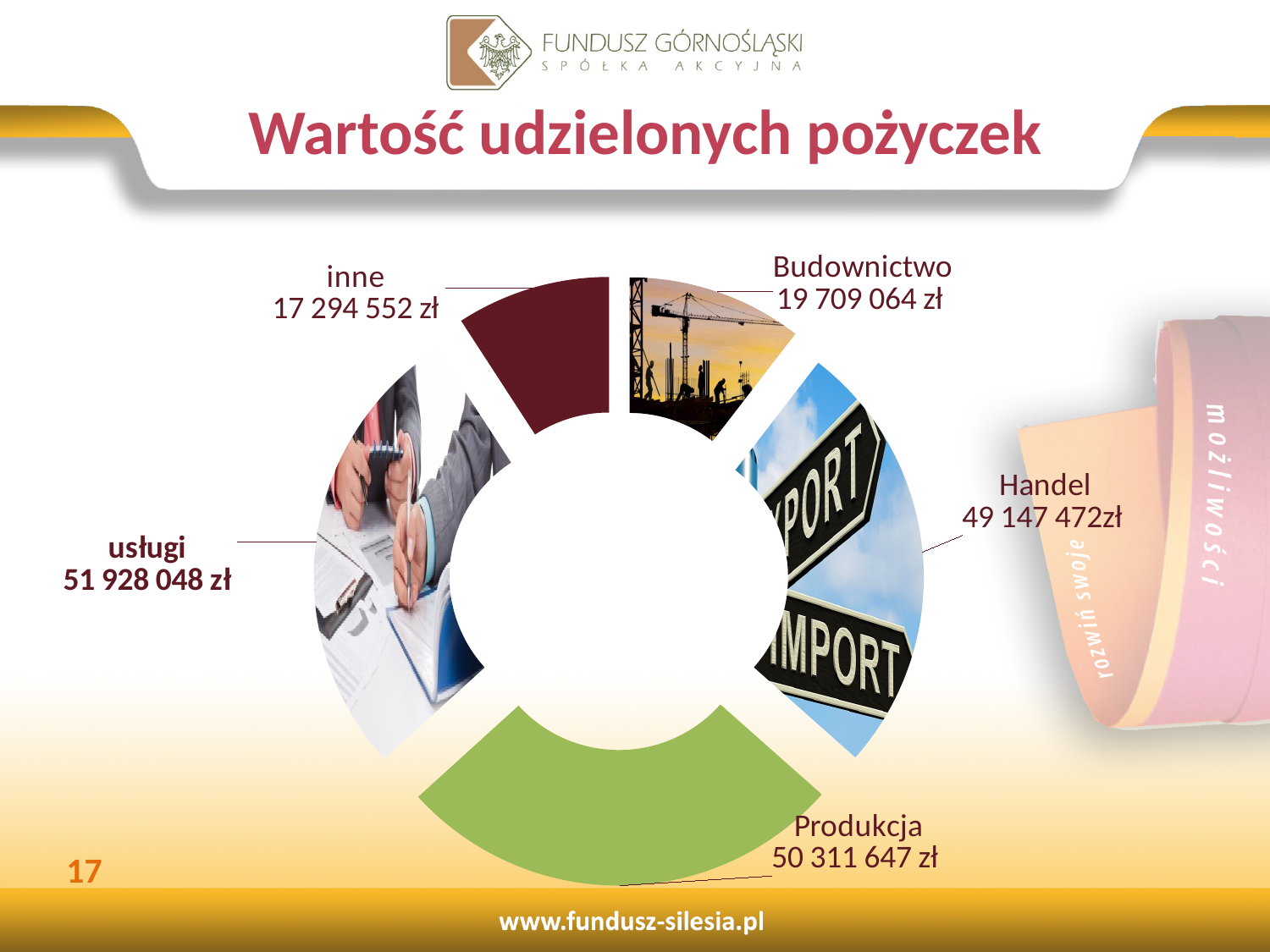
What is the value shown for inne? 17 294 552 zł What is the value of loans granted for Handel? 49 147 472zł What is the title of the slide containing the chart? Wartość udzielonych pożyczek Which category has the highest value of loans granted? usługi What is the difference between the values for Budownictwo and inne? 2 414 512 zł Which is larger, the value for Handel or the value for Produkcja? Produkcja What is the value shown for Produkcja? 50 311 647 zł What is the value shown for Budownictwo? 19 709 064 zł How many categories are shown in the chart? 5 What kind of chart is shown on the slide? Doughnut (pie) chart What is the difference between the values for usługi and Produkcja? 1 616 401 zł Which category has the lowest value of loans granted? inne